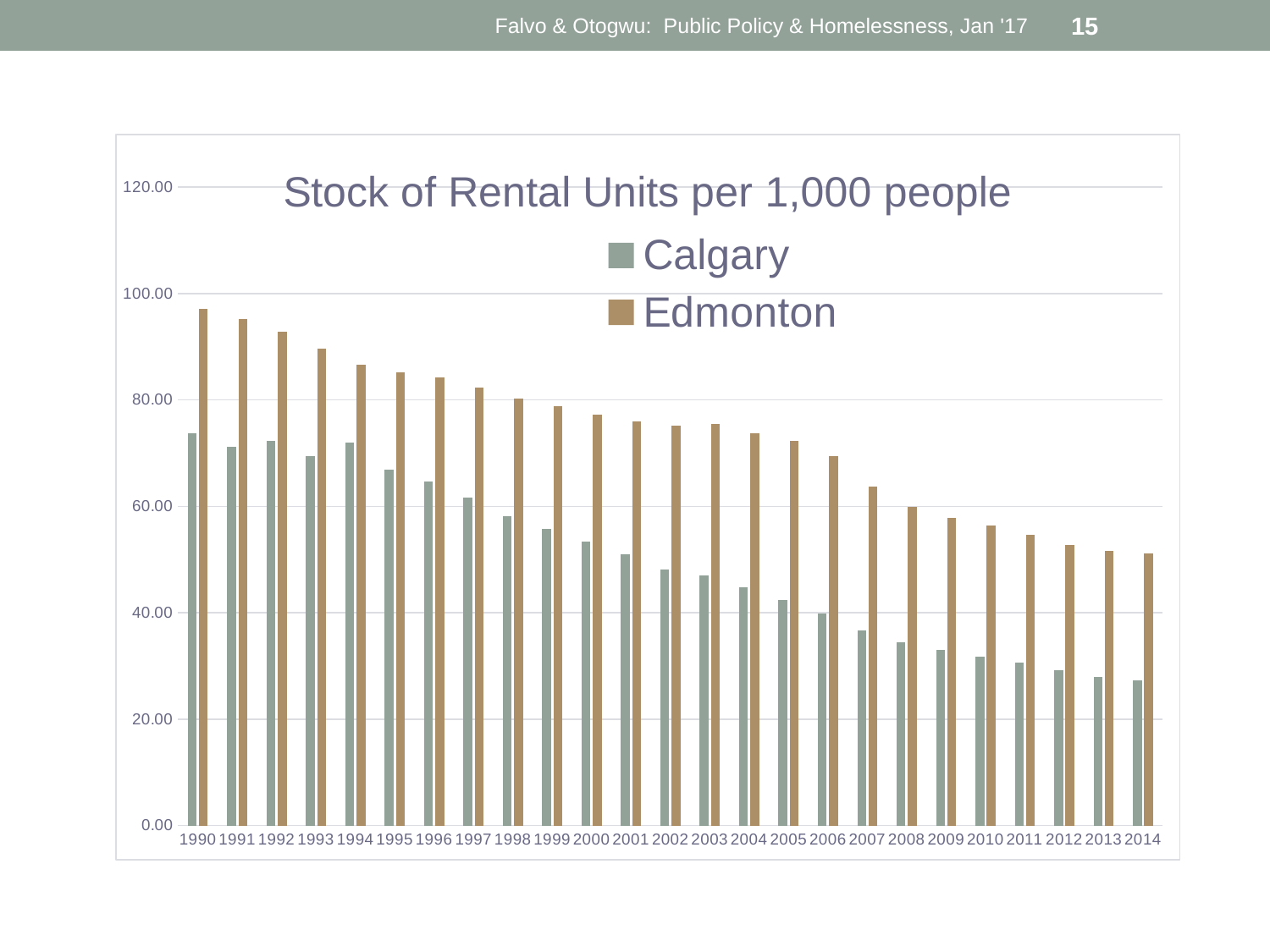
Is the value for Edmonton in 2014 greater or less than 40? greater Is the value for Calgary in 1990 greater or less than 60? greater What is the title of the chart? Stock of Rental Units per 1,000 people What type of chart is shown on the slide? bar chart How many series does the legend list? 2 Which two cities are shown in the legend? Calgary and Edmonton In 2000, which city has the larger value, Calgary or Edmonton? Edmonton Do the Calgary values generally rise or fall from 1990 to 2014? fall Is the value for Edmonton in 1990 greater or less than 80? greater How many years are shown on the x axis? 25 In which year is the Edmonton value highest? 1990